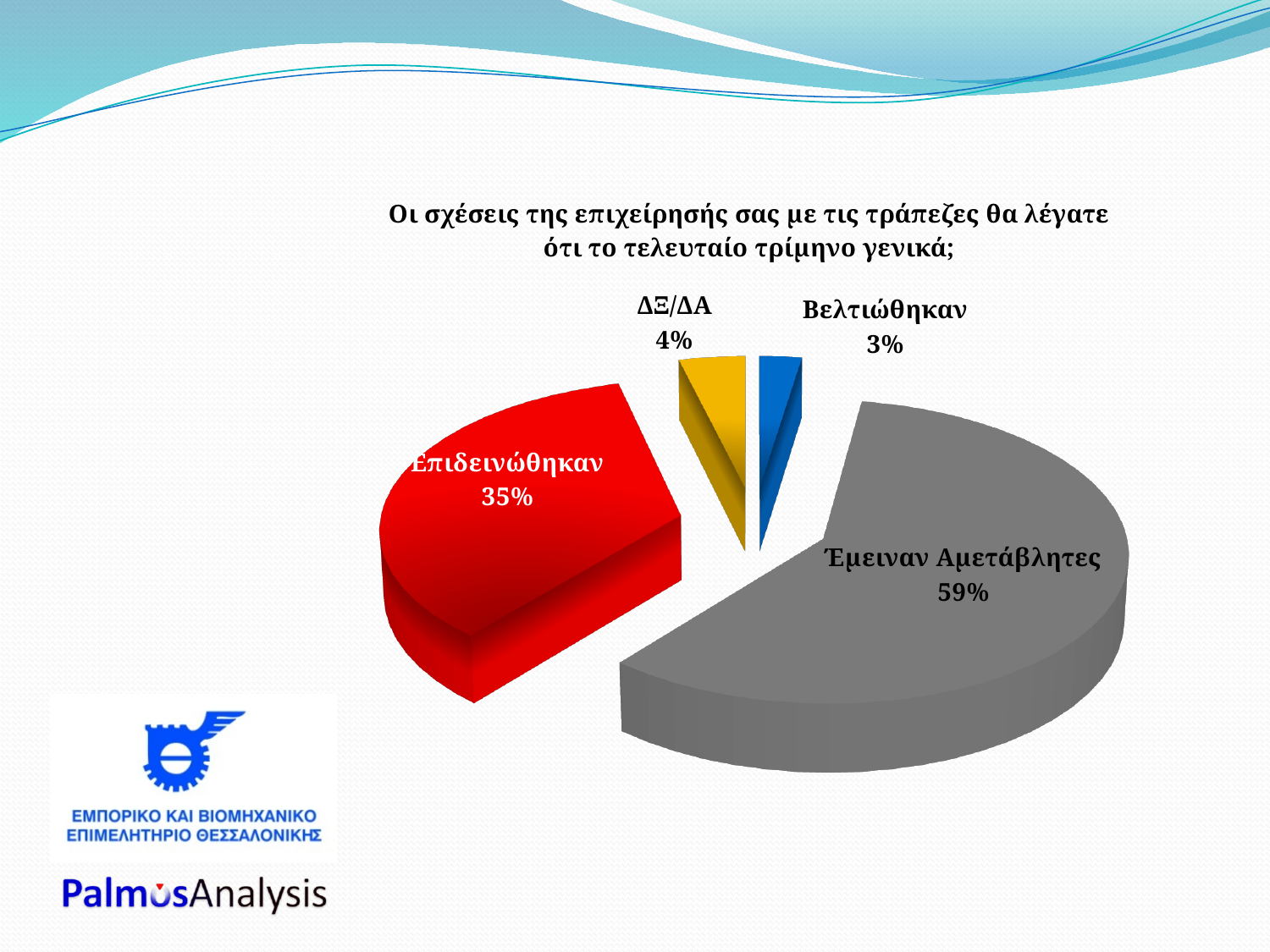
Which is larger, the value for ΔΞ/ΔΑ or the value for Βελτιώθηκαν? ΔΞ/ΔΑ Which category has the smallest slice of the pie? Βελτιώθηκαν What colour is the slice for Επιδεινώθηκαν? Red What is the value for Βελτιώθηκαν? 3% Which category has the largest slice of the pie? Έμειναν Αμετάβλητες What is the value for Επιδεινώθηκαν? 35% What share of the pie does Έμειναν Αμετάβλητες have? 59% What kind of chart is shown on the slide? Pie chart How many categories are shown in the pie chart? 4 What is the difference between the values for Έμειναν Αμετάβλητες and Επιδεινώθηκαν? 24% What is the value for ΔΞ/ΔΑ? 4% What colour is the slice for Έμειναν Αμετάβλητες? Grey